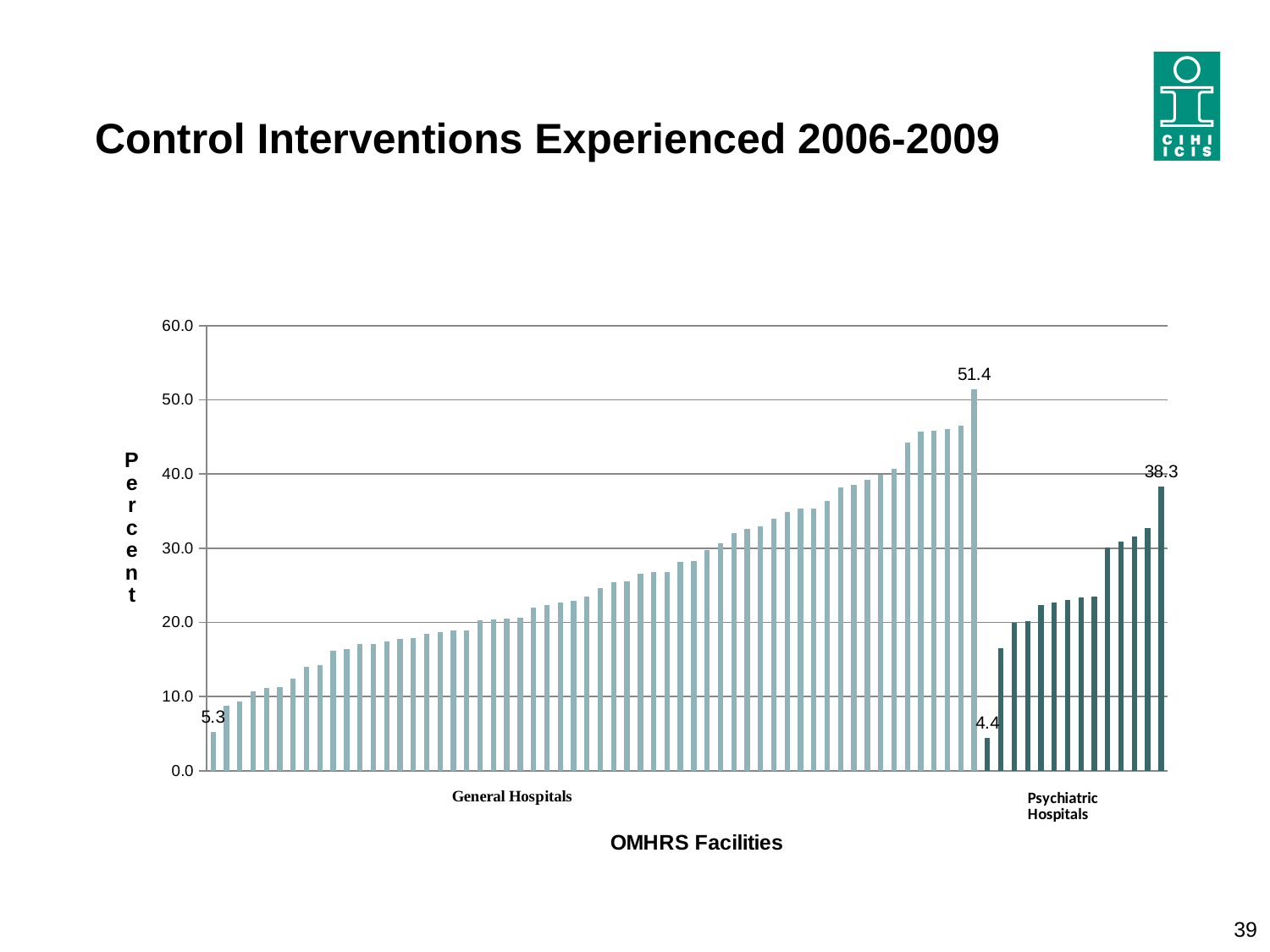
What is the difference between the lowest General Hospitals value (5.3) and the lowest Psychiatric Hospitals value (4.4)? 0.9 What is the highest value labelled among the Psychiatric Hospitals bars? 38.3 What is the lowest value labelled among the General Hospitals bars? 5.3 What is the highest value labelled among the General Hospitals bars? 51.4 Is the highest Psychiatric Hospitals value greater or less than 40.0? less Which facility group contains the tallest bar on the chart? General Hospitals What is the title of the horizontal axis? OMHRS Facilities Which facility group contains the shortest bar on the chart? Psychiatric Hospitals What is the lowest value labelled among the Psychiatric Hospitals bars? 4.4 What is the difference between the highest General Hospitals value (51.4) and the highest Psychiatric Hospitals value (38.3)? 13.1 What kind of chart is shown on the slide? Bar chart Within the General Hospitals group, do the bar values rise or fall from left to right? Rise